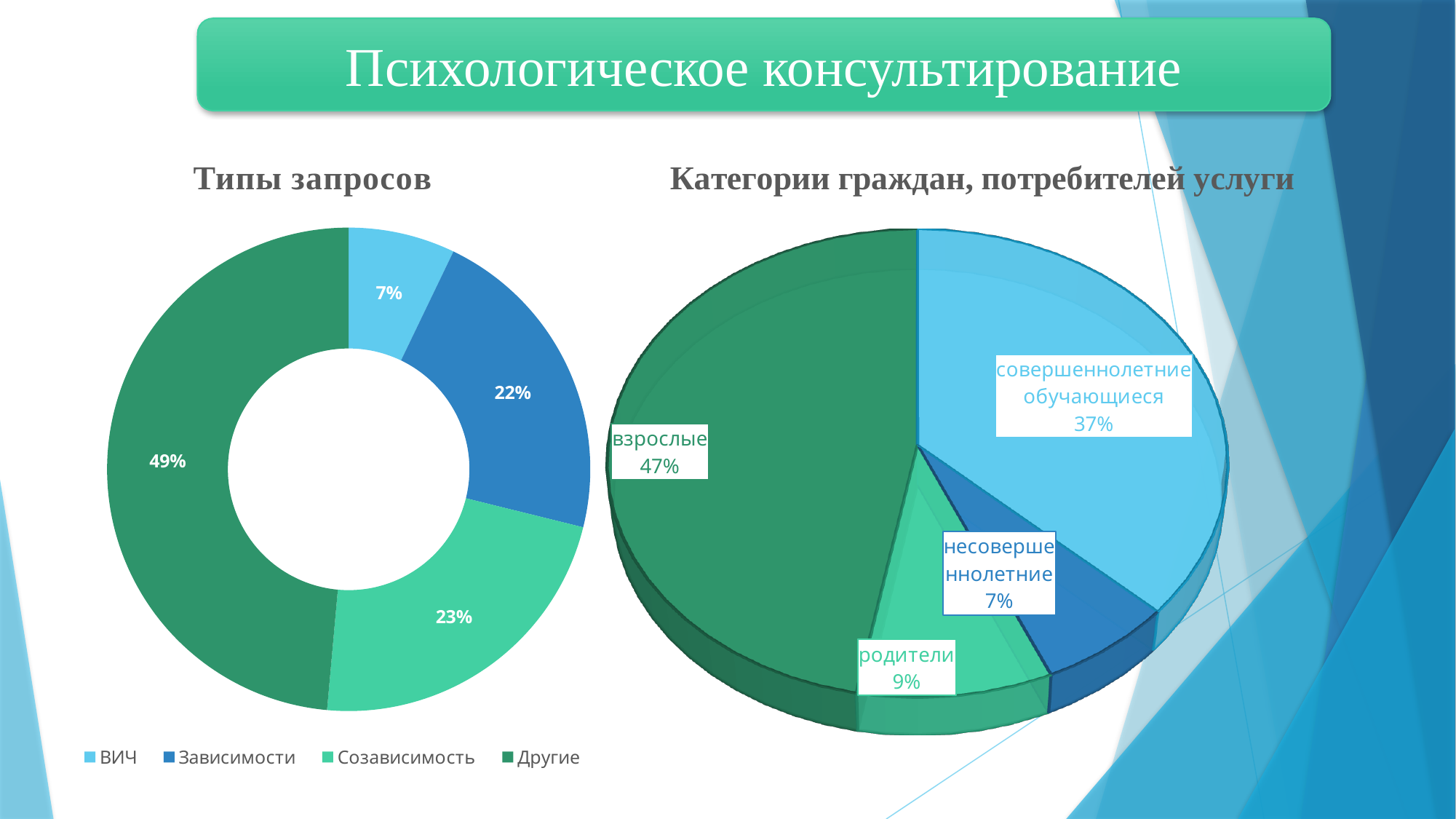
In the 'Типы запросов' chart, what share is labelled for ВИЧ? 7% In the 'Категории граждан, потребителей услуги' chart, what share is labelled for взрослые? 47% In the 'Типы запросов' chart, what share is labelled for Другие? 49% In the 'Категории граждан, потребителей услуги' chart, which is larger: совершеннолетние обучающиеся or взрослые? взрослые In the 'Типы запросов' chart, which category has the largest share? Другие What kind of chart is 'Типы запросов'? Doughnut chart In the 'Типы запросов' chart, how many entries does the legend list? 4 In the 'Категории граждан, потребителей услуги' chart, how many slices are there? 4 In the 'Типы запросов' chart, which category has the smallest share? ВИЧ In the 'Типы запросов' chart, what is the difference in percentage points between Созависимость and Зависимости? 1 In the 'Категории граждан, потребителей услуги' chart, what share is labelled for родители? 9% In the 'Категории граждан, потребителей услуги' chart, which category has the smallest share? несовершеннолетние